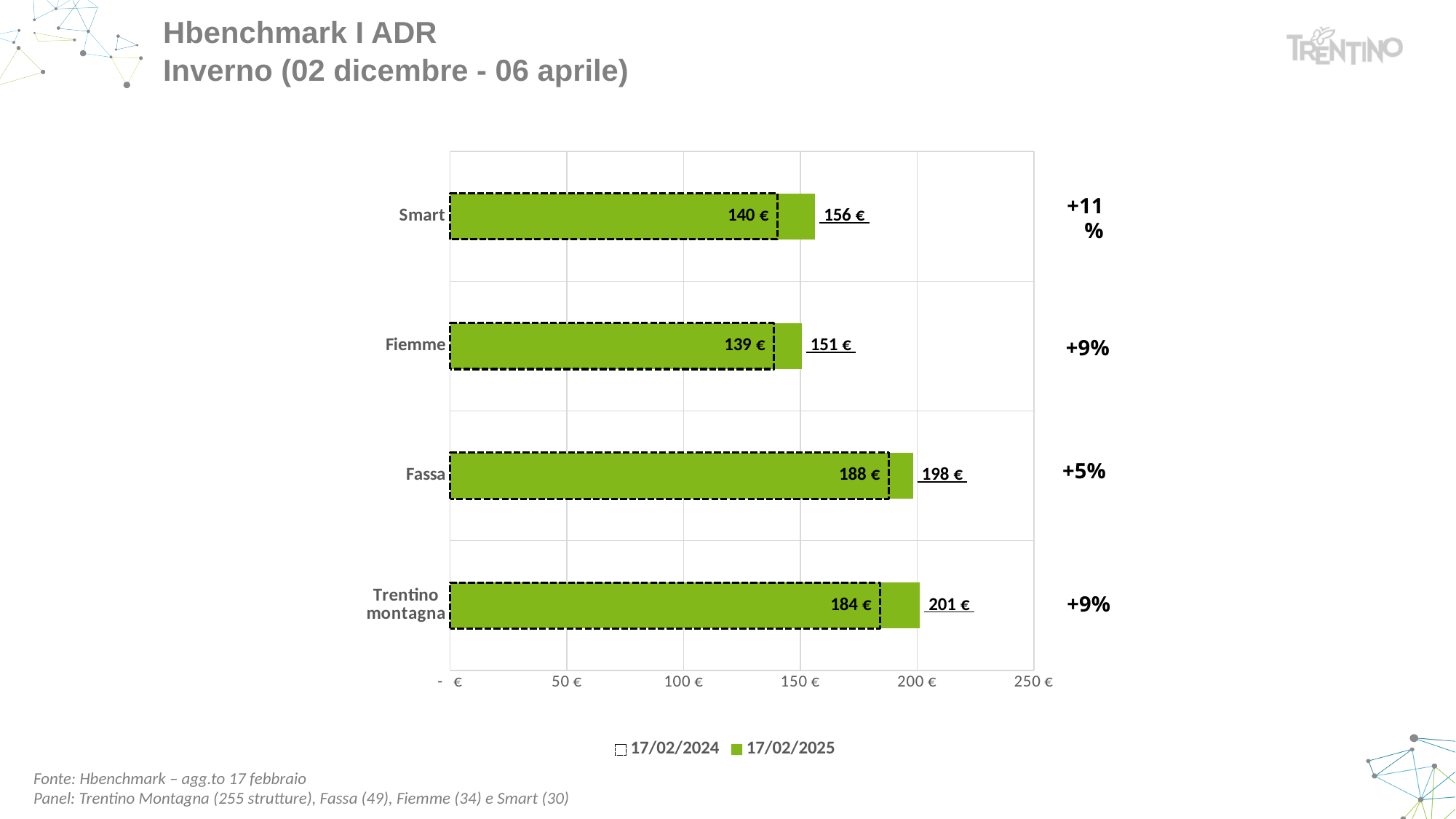
Which is larger: the 17/02/2025 value for Fassa or the 17/02/2025 value for Fiemme? Fassa What is the ADR value for Trentino montagna on 17/02/2025? 201 € Which category has the highest ADR value for 17/02/2025? Trentino montagna What is the ADR value for Smart on 17/02/2025? 156 € What percentage change is shown next to the Smart bars? +11% What is the ADR value for Fiemme on 17/02/2024? 139 € What is the difference between the 17/02/2025 and 17/02/2024 ADR values for Smart? 16 € What is the ADR value for Fassa on 17/02/2024? 188 € How many series does the legend list? 2 How many categories are shown on the chart? 4 Which category has the lowest ADR value for 17/02/2024? Fiemme What kind of chart is shown on the slide? Bar chart